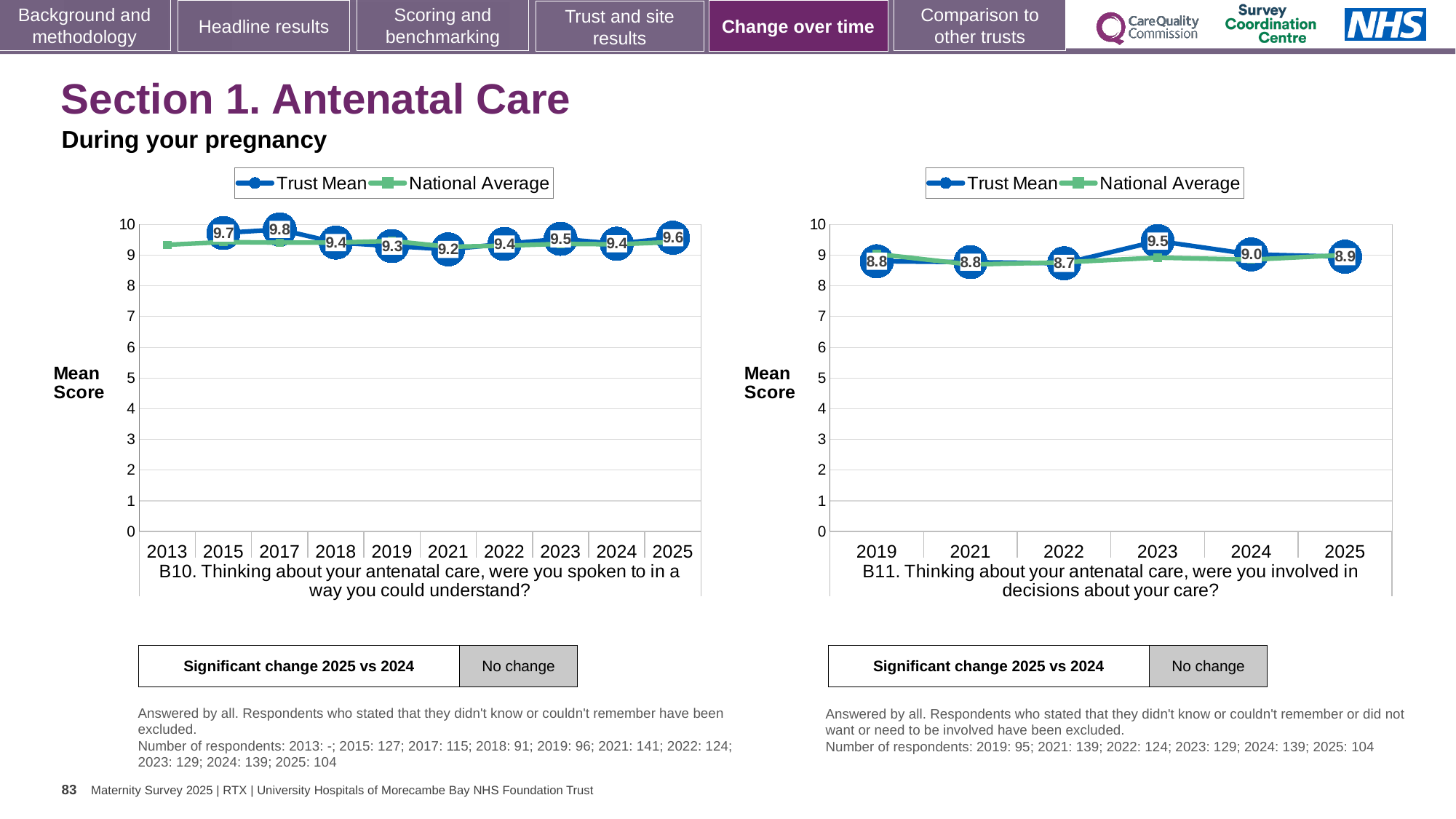
In the B10 chart on the left, which year has the lowest Trust Mean? 2021 In the B10 chart on the left, which year has the highest Trust Mean? 2017 In the B10 chart on the left, how many years are shown on the x axis? 10 In the B11 chart on the right, what is the Trust Mean for 2023? 9.5 In the B10 chart on the left, what is the Trust Mean for 2021? 9.2 What kind of chart is the B11 chart on the right? Line chart In the B11 chart on the right, which year has the lowest Trust Mean? 2022 In the B11 chart on the right, is the Trust Mean for 2022 greater or less than 8? greater In the B11 chart on the right, is the Trust Mean for 2024 or for 2025 larger? 2024 In the B11 chart on the right, how many series does the legend list? 2 In the B10 chart on the left, what is the difference between the Trust Mean for 2017 and for 2021? 0.6 In the B10 chart on the left, what is the Trust Mean for 2025? 9.6